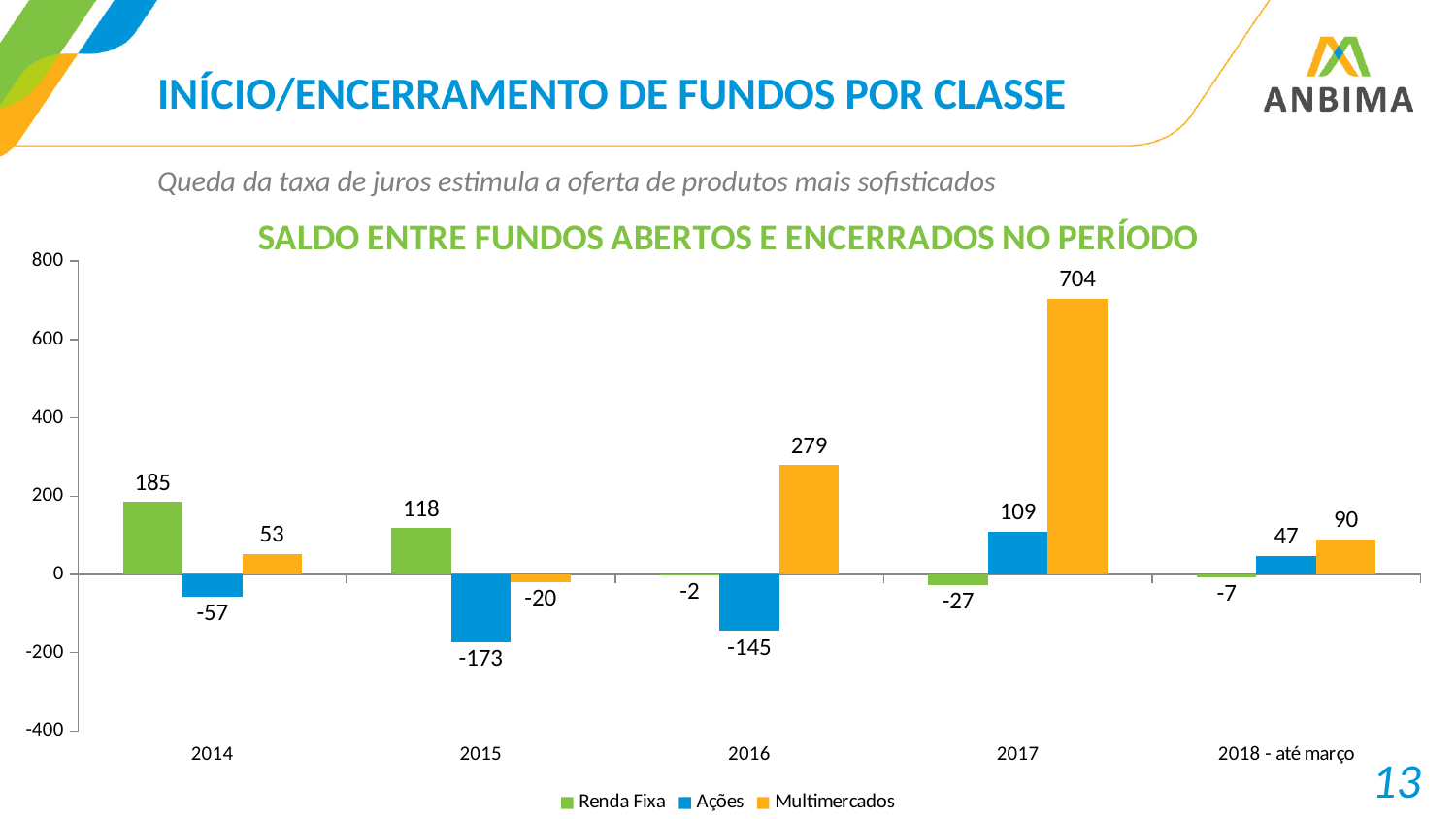
Which year has the lowest Ações value? 2015 How many series does the legend list? 3 What is the title of the chart? SALDO ENTRE FUNDOS ABERTOS E ENCERRADOS NO PERÍODO How many periods are shown on the x axis? 5 What is the value for Multimercados in 2017? 704 What is the difference between the Multimercados values for 2017 and 2016? 425 What kind of chart is shown on the slide? Bar chart What is the value for Ações in 2015? -173 What is the value for Multimercados in 2018 - até março? 90 What is the value for Renda Fixa in 2014? 185 Which is larger, the Renda Fixa value in 2014 or in 2015? 2014 Which year has the highest Multimercados value? 2017